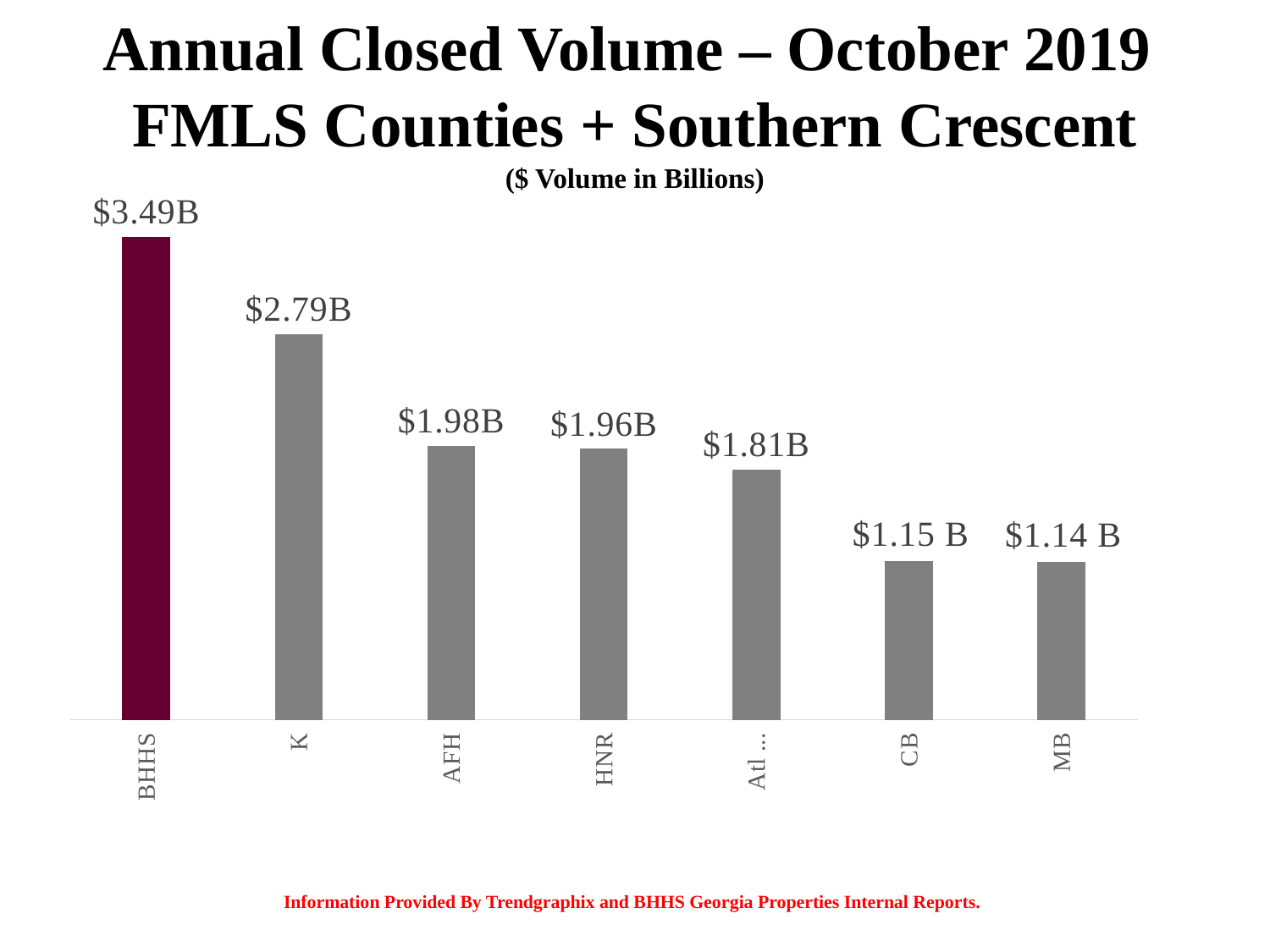
What is the difference in annual closed volume between BHHS and K? $0.70B What is the annual closed volume for K? $2.79B What is the annual closed volume for BHHS? $3.49B What is the annual closed volume for CB? $1.15 B Do the values rise or fall moving from left to right across the chart? Fall What is the annual closed volume for HNR? $1.96B Which company has the highest annual closed volume? BHHS What kind of chart is shown on the slide? Bar chart Which has a larger annual closed volume, AFH or HNR? AFH How many companies are shown in the chart? 7 In what units is the volume shown, according to the chart subtitle? $ Volume in Billions Which company has the lowest annual closed volume? MB